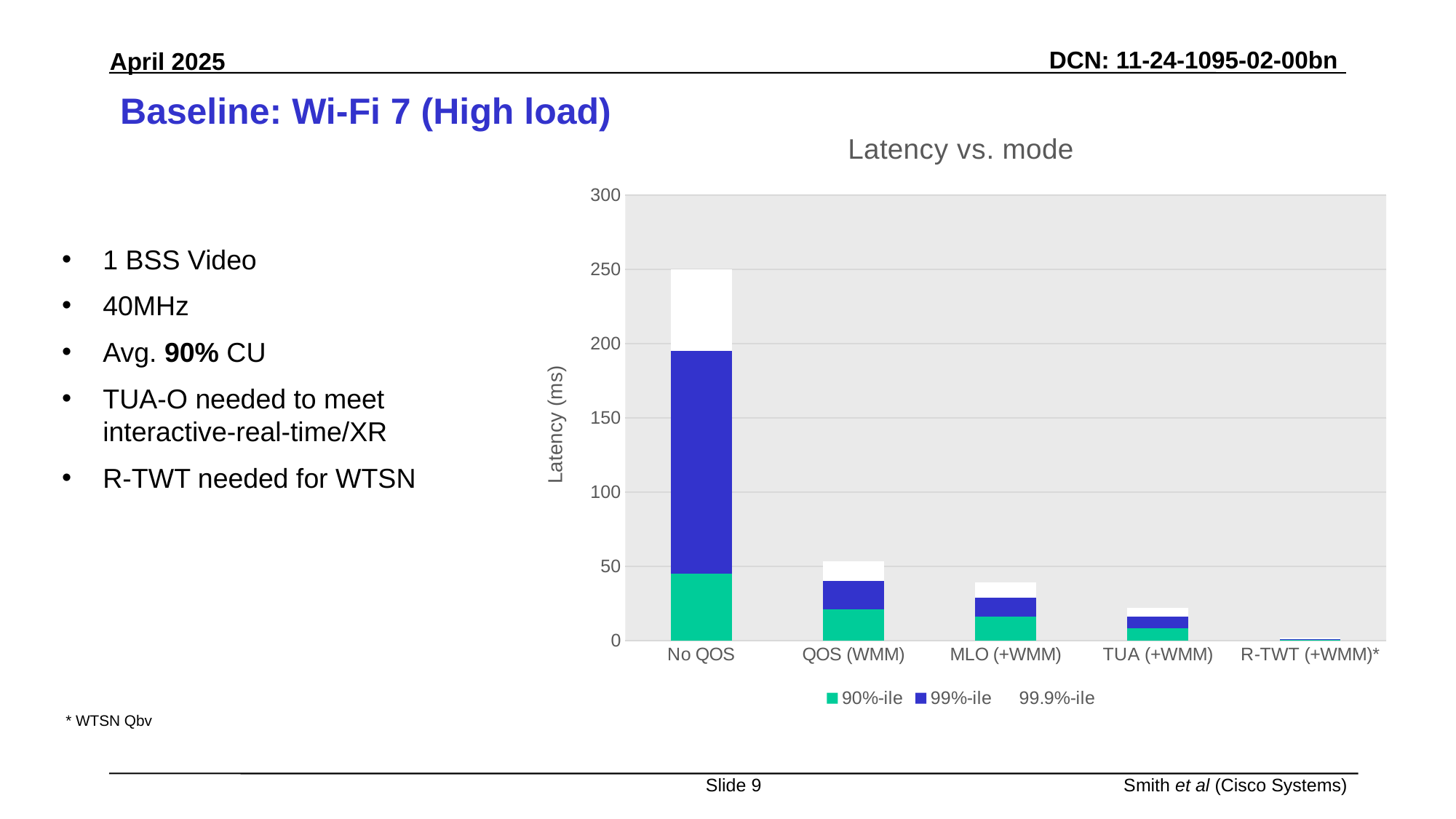
How many modes (categories) are shown on the x axis of the chart? 5 Is the total latency bar for No QOS greater or less than 200? greater Which mode has the highest total latency bar? No QOS Which mode has the lowest total latency bar? R-TWT (+WMM)* Is the total latency bar for QOS (WMM) greater or less than 100? less Do the total latency bars rise or fall moving from left to right along the x axis? fall Which has a larger total latency bar, MLO (+WMM) or TUA (+WMM)? MLO (+WMM) What kind of chart is shown on the slide? stacked bar chart Is the 90%-ile value for No QOS greater or less than 100? less How many series does the chart legend list? 3 What is the title of the chart? Latency vs. mode What is the label on the vertical axis of the chart? Latency (ms)